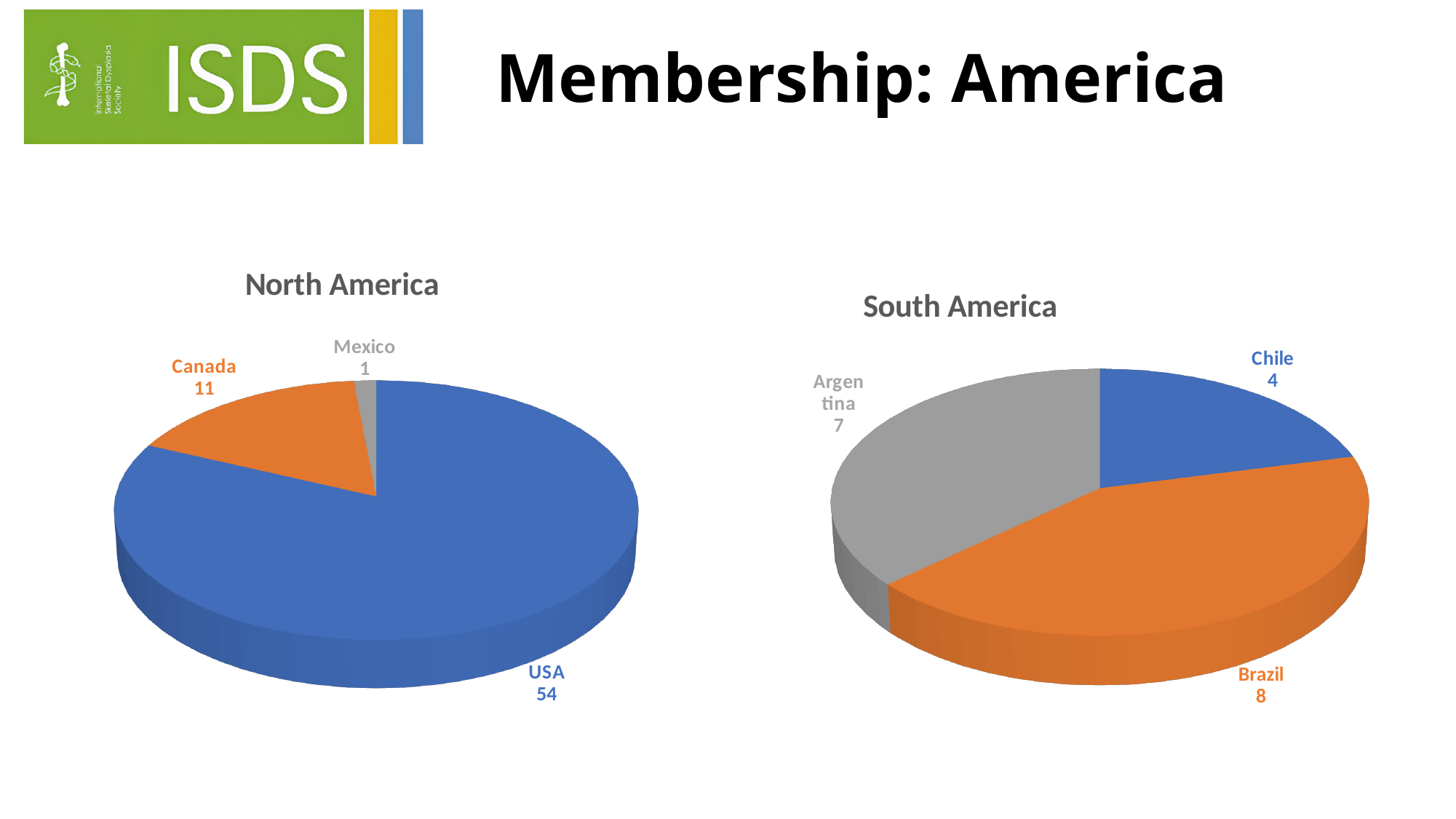
In the South America chart, what is the value for Argentina? 7 In the North America chart, which country has the lowest value? Mexico In the North America chart, what is the value for USA? 54 In the North America chart, what is the difference between the values for USA and Canada? 43 What is the title of the chart on the right side of the slide? South America In the North America chart, what is the value for Canada? 11 In the South America chart, which country has the highest value? Brazil How many countries are shown in the South America chart? 3 In the South America chart, which is larger, the value for Brazil or the value for Chile? Brazil What is the total of all slices in the South America chart? 19 What kind of chart is the North America chart? Pie chart In the North America chart, what share of the total does Mexico represent? 1 of 66